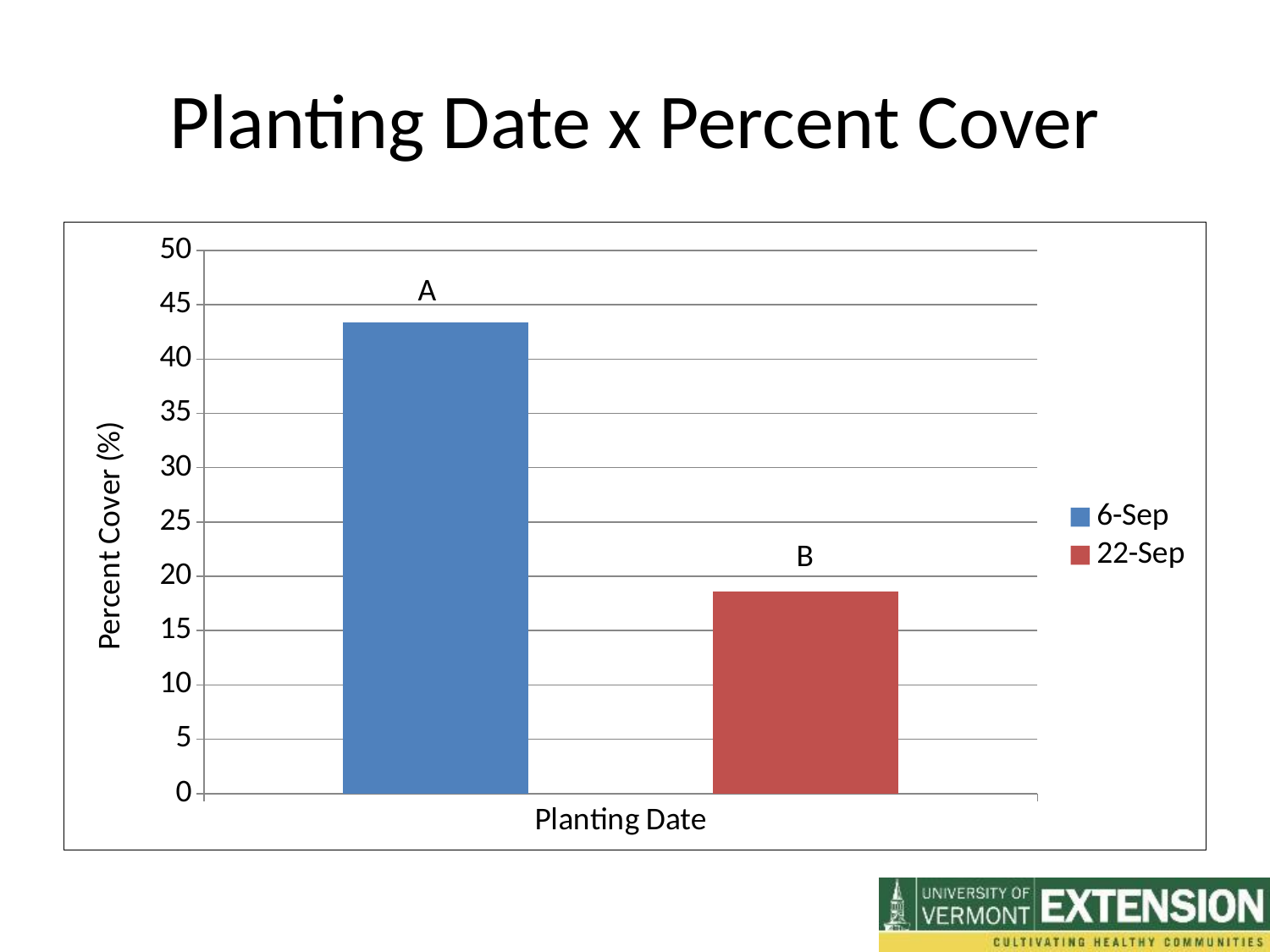
Is the percent cover for 6-Sep greater or less than 45? less What is the label on the vertical axis of the chart? Percent Cover (%) Which has a larger percent cover, 6-Sep or 22-Sep? 6-Sep Which planting date has the lowest percent cover? 22-Sep How many bars are plotted in the chart? 2 Which planting date has the highest percent cover? 6-Sep Is the percent cover for 22-Sep greater or less than 20? less What is the title of the slide? Planting Date x Percent Cover How many series does the legend list? 2 What kind of chart is shown on the slide? bar chart Is the percent cover for 6-Sep greater or less than 40? greater